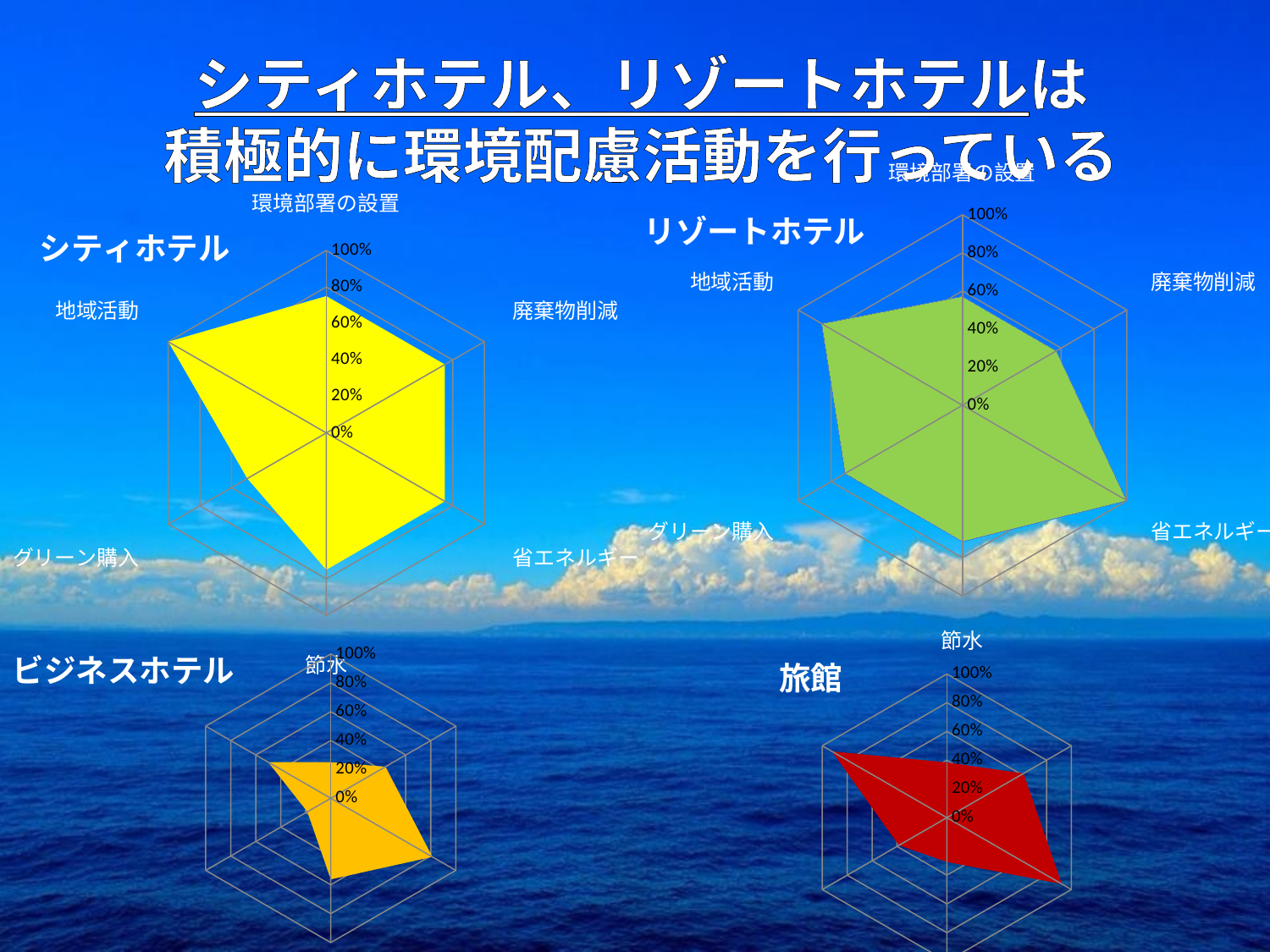
What colour is the filled area in the 旅館 chart? red In the シティホテル chart, is the value for 地域活動 greater or less than 80%? greater In the シティホテル chart, is the value for 環境部署の設置 greater or less than 40%? greater In the 旅館 chart, is the value for 節水 greater or less than 60%? less In the シティホテル chart, which is larger: 地域活動 or グリーン購入? 地域活動 In the シティホテル chart, which category has the highest value? 地域活動 What kind of chart is the シティホテル chart? radar chart How many axes (categories) does the シティホテル radar chart have? 6 How many charts are shown on the slide? 4